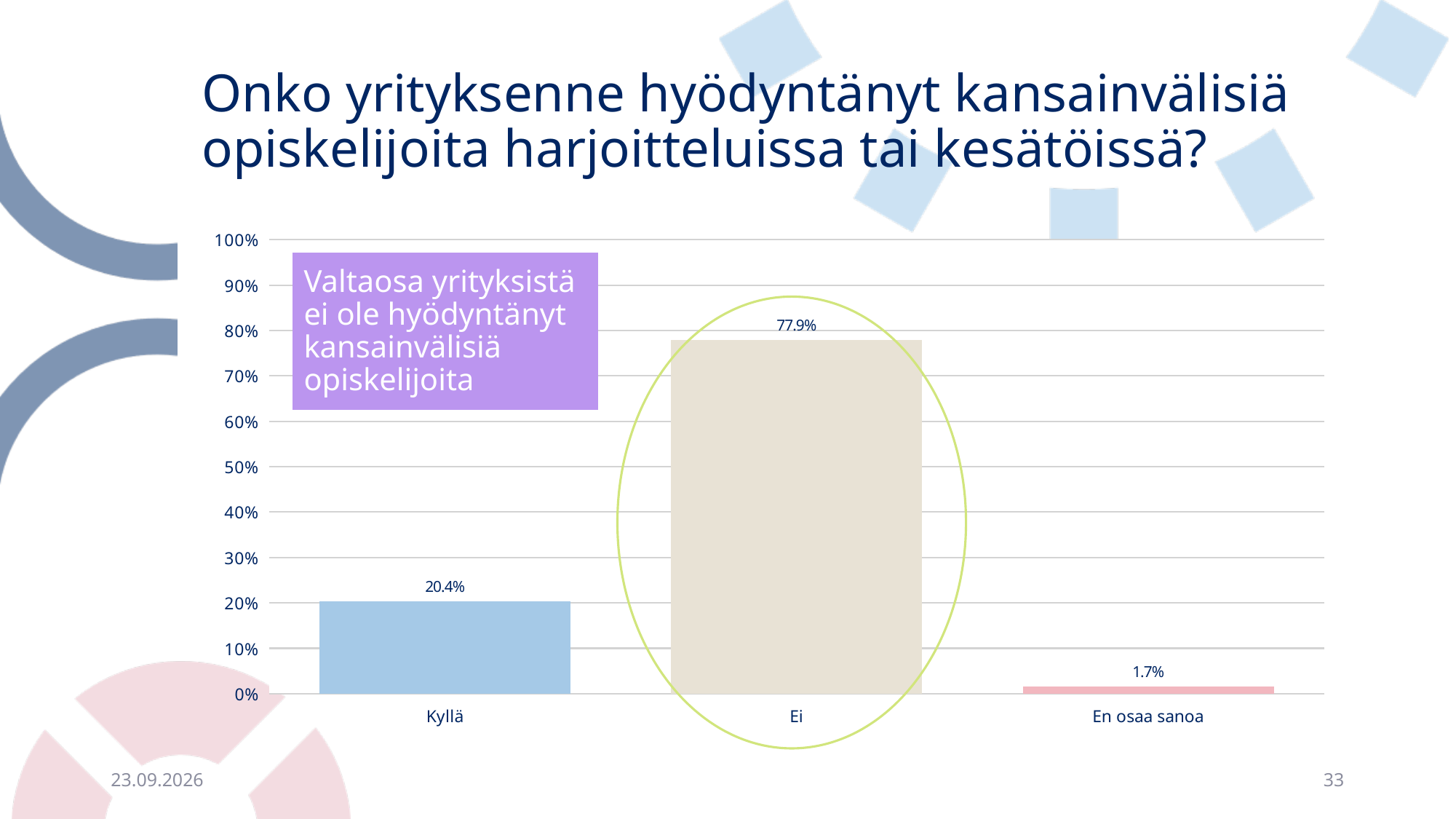
Is the value for Ei greater or less than 70%? greater What is the difference between the values for Ei and Kyllä? 57.5% Which category is highlighted with a circle on the chart? Ei What is the value for Ei? 77.9% What is the value for Kyllä? 20.4% What is the difference between the values for Kyllä and En osaa sanoa? 18.7% How many categories are shown on the x axis? 3 Which is larger, the value for Kyllä or the value for En osaa sanoa? Kyllä Which category has the lowest value? En osaa sanoa Which category has the highest value? Ei What kind of chart is shown on the slide? bar chart What is the value for En osaa sanoa? 1.7%